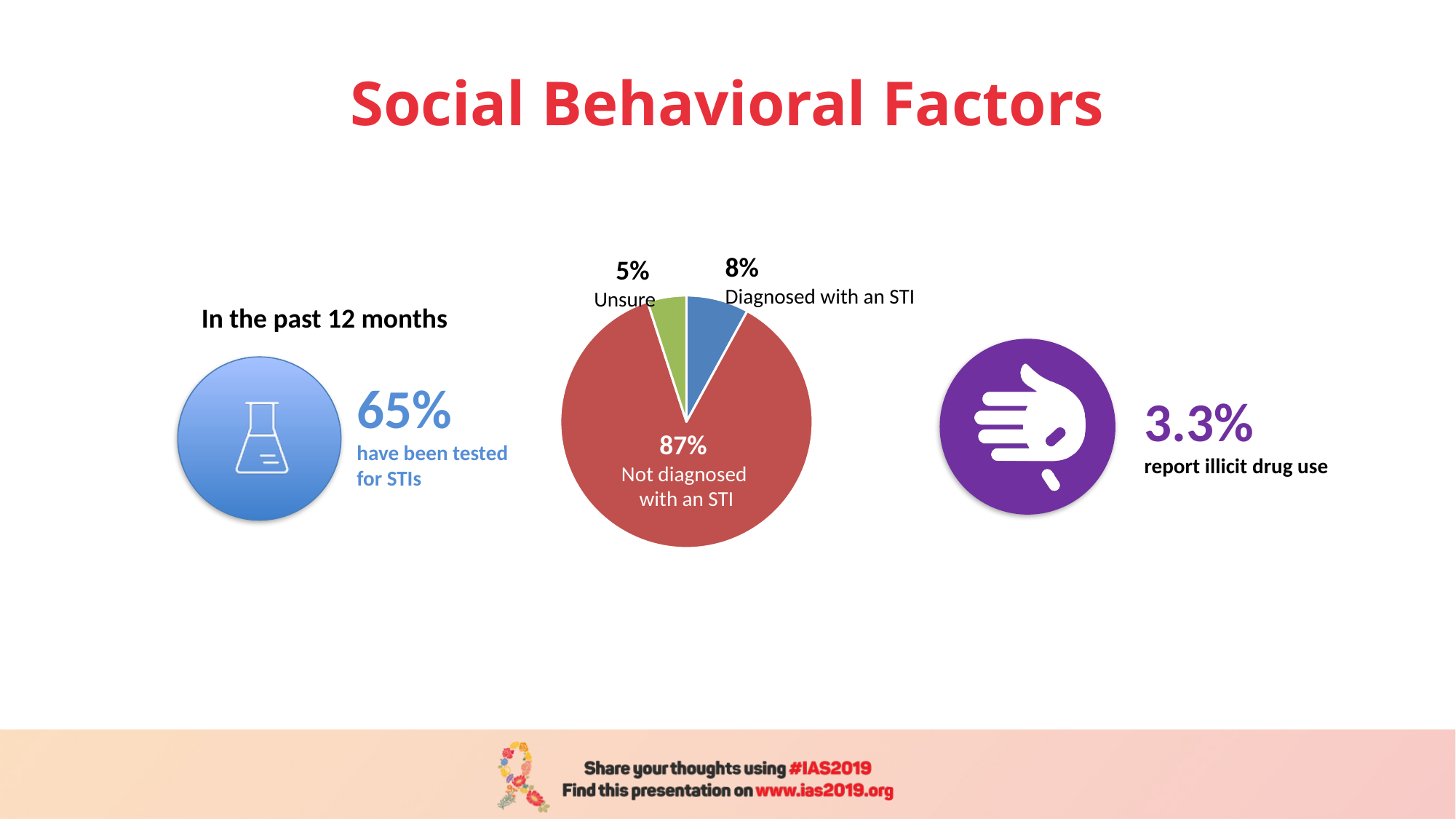
How many slices does the pie chart have? 3 Which is larger in the pie chart: 'Diagnosed with an STI' or 'Unsure'? Diagnosed with an STI Which slice of the pie chart is the smallest? Unsure What is the difference in percentage points between the 'Not diagnosed with an STI' slice and the 'Diagnosed with an STI' slice? 79 What percentage of the pie chart is labelled 'Diagnosed with an STI'? 8% What colour is the 'Unsure' slice of the pie chart? green What kind of chart is shown in the centre of the slide? pie chart What percentage of the pie chart is labelled 'Not diagnosed with an STI'? 87% Which slice of the pie chart is the largest? Not diagnosed with an STI What is the combined share of the 'Diagnosed with an STI' and 'Unsure' slices? 13% What colour is the 'Not diagnosed with an STI' slice of the pie chart? red What percentage of the pie chart is labelled 'Unsure'? 5%